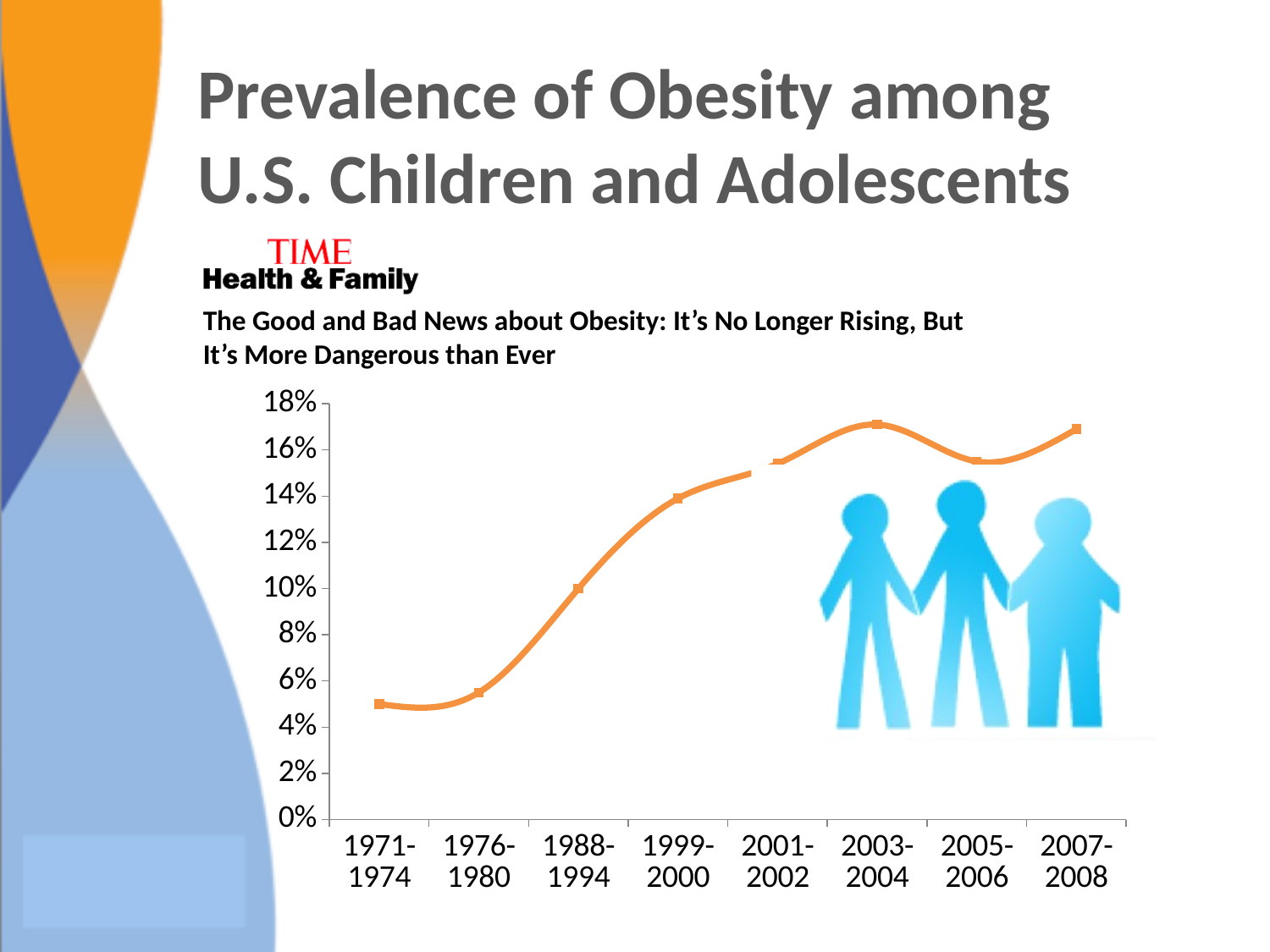
Is the value for 2003-2004 greater or less than 16%? greater Overall, do the values rise or fall from 1971-1974 to 2007-2008? rise How many time periods are plotted along the x axis? 8 What is the title of the slide containing the chart? Prevalence of Obesity among U.S. Children and Adolescents Is the value for 2001-2002 greater or less than 14%? greater Which time period has the lowest obesity prevalence? 1971-1974 Which is larger, the value for 1976-1980 or the value for 2007-2008? 2007-2008 Which is larger, the value for 1988-1994 or the value for 1999-2000? 1999-2000 Is the value for 1999-2000 greater or less than 12%? greater What kind of chart is shown on the slide? line chart